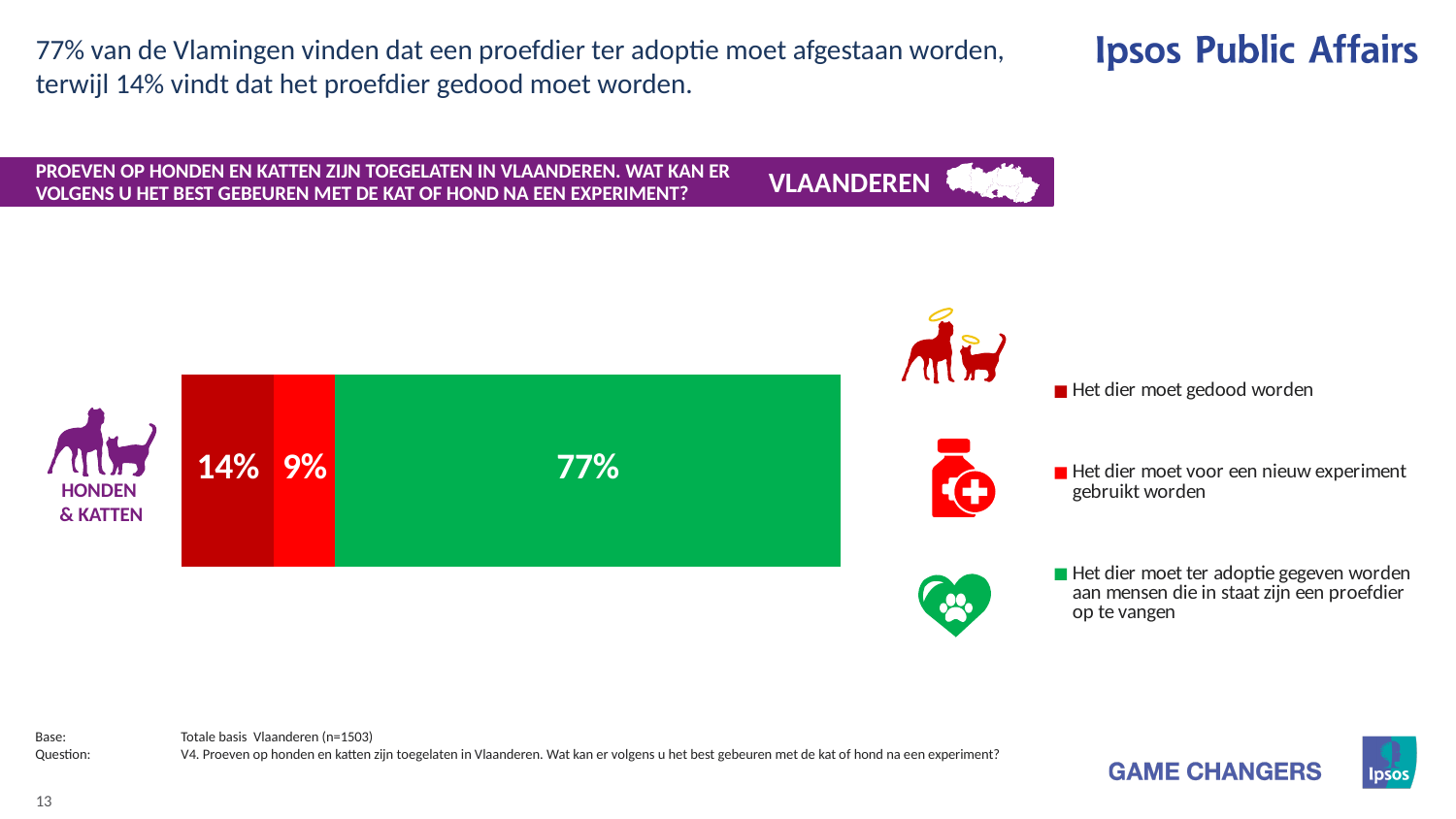
What kind of chart is shown on the slide? Stacked bar chart What is the total of the three segments in the stacked bar? 100% What percentage of respondents say the animal should be used for a new experiment? 9% What is the difference between the share for adoption (77%) and the share for killing the animal (14%)? 63% What is the difference between the share for killing the animal (14%) and the share for a new experiment (9%)? 5% What percentage of respondents say the animal should be given up for adoption? 77% What percentage of respondents say the animal should be killed ("Het dier moet gedood worden")? 14% Which is larger: the share for killing the animal or the share for using it in a new experiment? Killing the animal (14%) Which response option has the largest share in the bar? Het dier moet ter adoptie gegeven worden aan mensen die in staat zijn een proefdier op te vangen What colour is the segment representing "Het dier moet ter adoptie gegeven worden"? Green How many series does the legend list? 3 Which response option has the smallest share in the bar? Het dier moet voor een nieuw experiment gebruikt worden